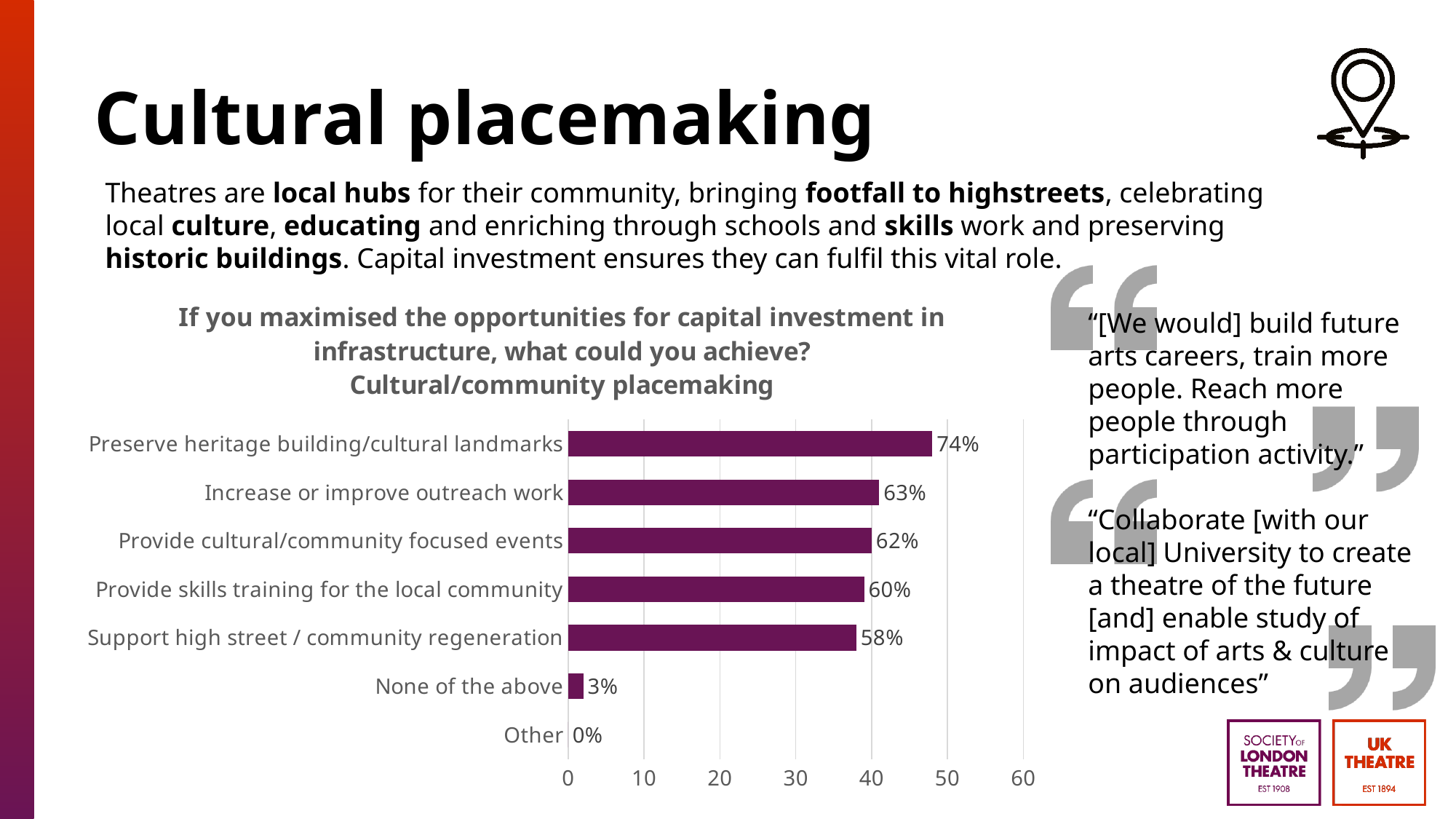
What is the value for "Provide skills training for the local community"? 60% What is the value for "Increase or improve outreach work"? 63% How many categories are shown in the chart? 7 Which category has the highest value? Preserve heritage building/cultural landmarks Which is larger: the value for "Provide cultural/community focused events" or "Support high street / community regeneration"? Provide cultural/community focused events What is the value for "None of the above"? 3% What kind of chart is shown on the slide? Bar chart What is the last line of the chart's title? Cultural/community placemaking Which category has the lowest value? Other What is the value for "Preserve heritage building/cultural landmarks"? 74% What is the difference between the values for "Preserve heritage building/cultural landmarks" and "Increase or improve outreach work"? 11% What is the value for "Support high street / community regeneration"? 58%